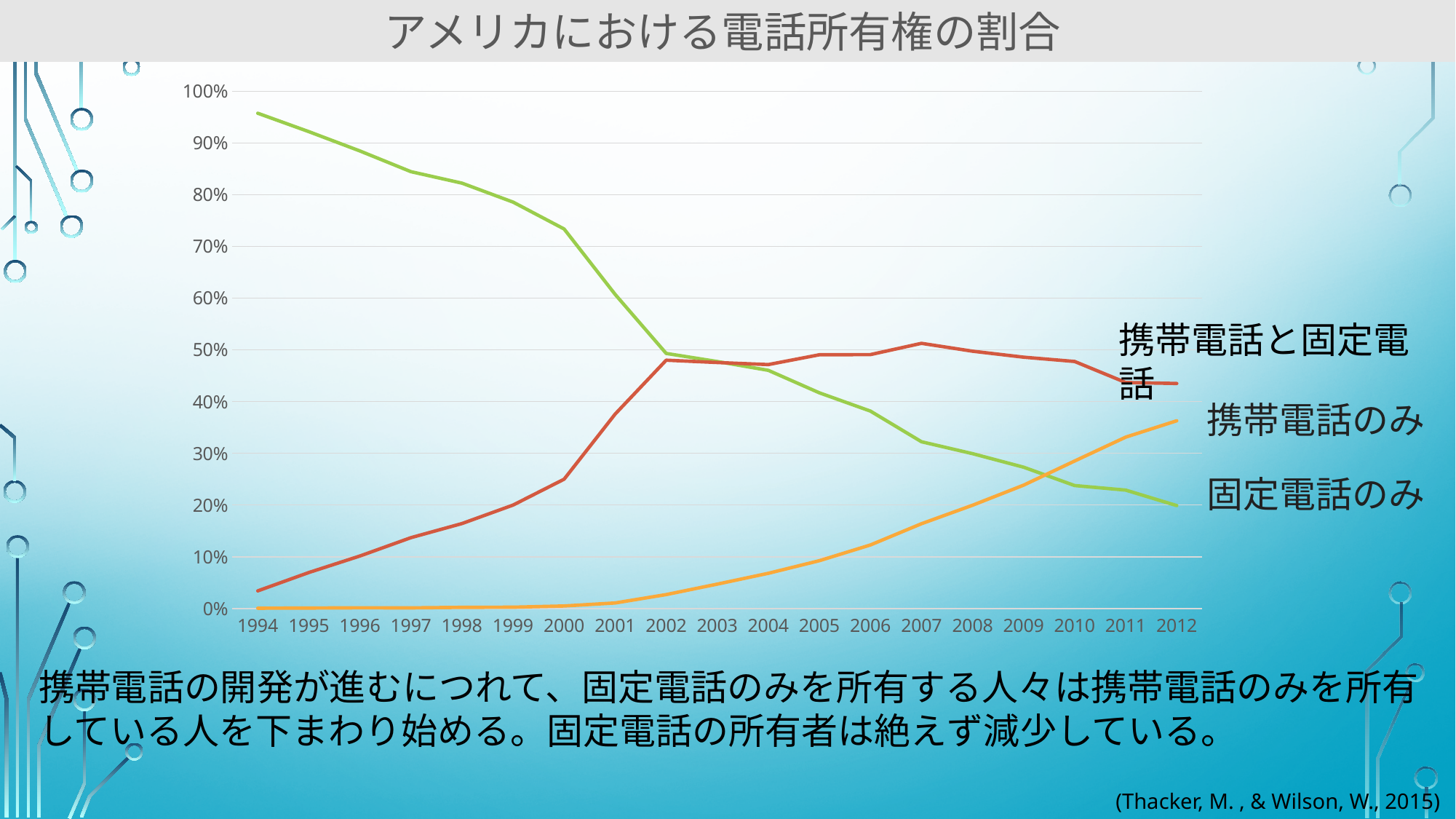
Does the value for 携帯電話のみ rise or fall from 1994 to 2012? rise How many years are shown on the x axis? 19 Is the value for 携帯電話のみ in 2012 greater or less than 30%? greater In 2012, which is larger: 携帯電話のみ or 固定電話のみ? 携帯電話のみ Is the value for 固定電話のみ in 2012 greater or less than 30%? less In which year is the value for 固定電話のみ highest? 1994 How many series are plotted on the chart? 3 Is the value for 携帯電話と固定電話 in 2000 greater or less than 30%? less What kind of chart is shown on the slide? line chart Does the value for 固定電話のみ rise or fall from 1994 to 2012? fall What is the title of the chart? アメリカにおける電話所有権の割合